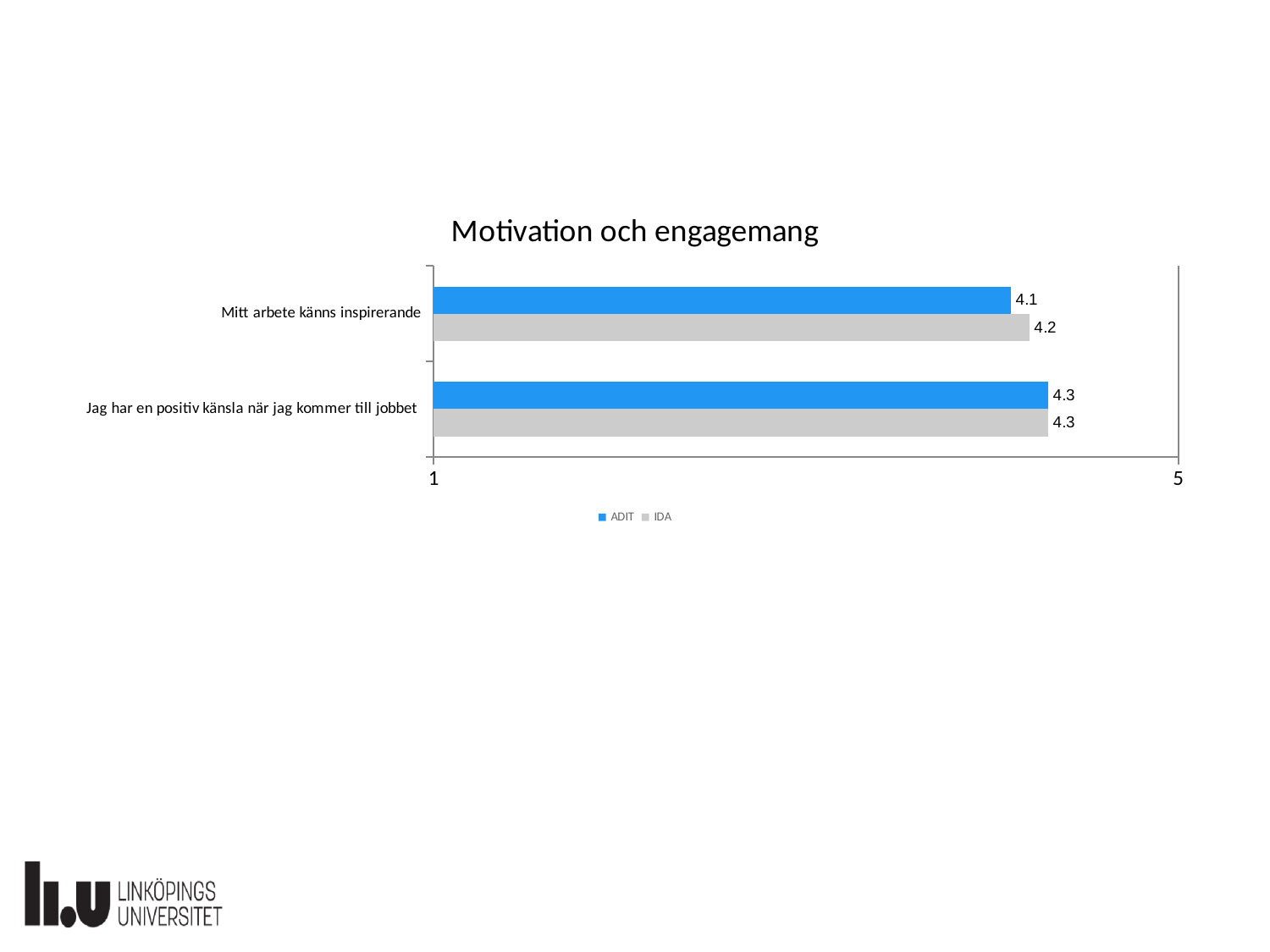
How many categories are shown on the chart? 2 What is the difference between the IDA and ADIT values for "Mitt arbete känns inspirerande"? 0.1 What is the ADIT value for "Jag har en positiv känsla när jag kommer till jobbet"? 4.3 Which series is shown in blue in the legend? ADIT What is the IDA value for "Jag har en positiv känsla när jag kommer till jobbet"? 4.3 Which category has the lowest ADIT value? Mitt arbete känns inspirerande What type of chart is shown on the slide? bar chart What is the ADIT value for "Mitt arbete känns inspirerande"? 4.1 How many series does the legend list? 2 Which series has the higher value for "Mitt arbete känns inspirerande", ADIT or IDA? IDA What is the IDA value for "Mitt arbete känns inspirerande"? 4.2 What is the title of the chart? Motivation och engagemang